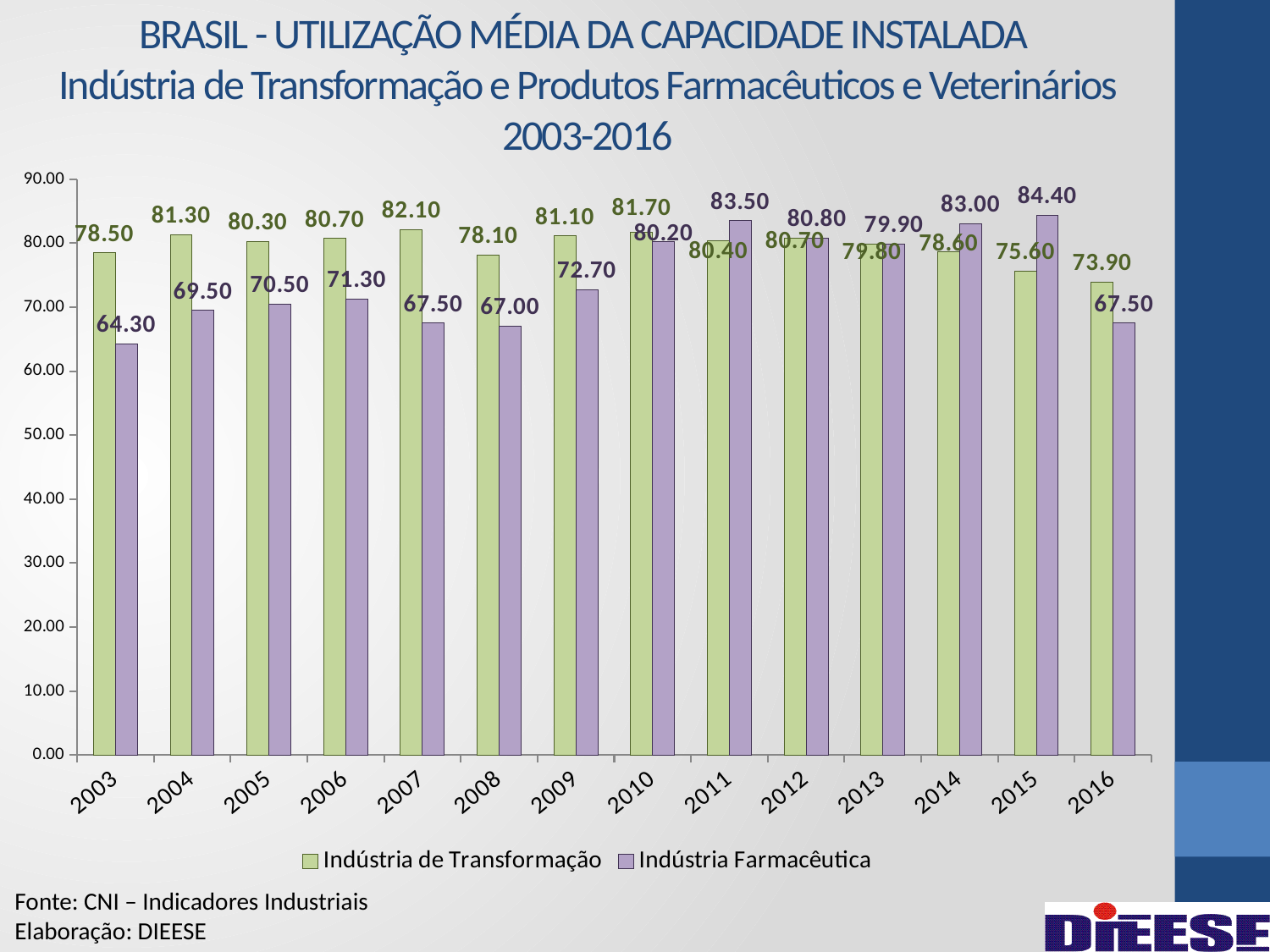
How many years are shown on the x axis? 14 What is the value for Indústria de Transformação in 2007? 82.10 Which colour represents Indústria Farmacêutica in the chart? Purple In which year is the Indústria Farmacêutica value highest? 2015 What is the value for Indústria Farmacêutica in 2003? 64.30 What is the difference between Indústria de Transformação and Indústria Farmacêutica in 2003? 14.20 In which year is the Indústria de Transformação value lowest? 2016 What kind of chart is shown on the slide? Bar chart How many series does the legend list? 2 Which series has the larger value in 2014, Indústria de Transformação or Indústria Farmacêutica? Indústria Farmacêutica In which year is the Indústria Farmacêutica value lowest? 2003 What is the value for Indústria Farmacêutica in 2015? 84.40